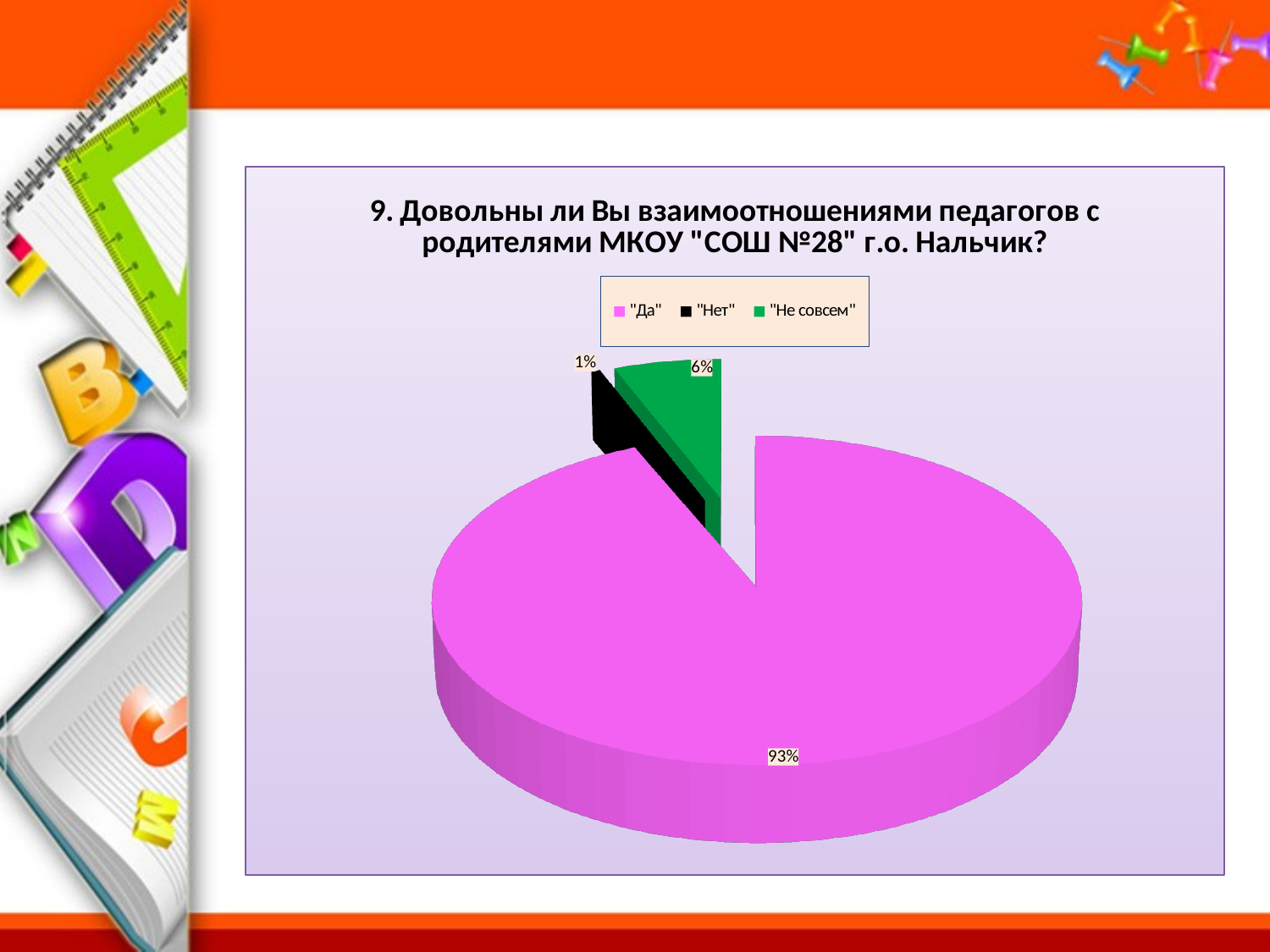
Which answer has the smallest share of the pie? "Нет" What colour is the slice for "Не совсем"? Green What is the difference in percentage points between "Не совсем" and "Нет"? 5 What is the difference in percentage points between "Да" and "Не совсем"? 87 Which is larger, the share for "Не совсем" or the share for "Нет"? "Не совсем" What percentage of respondents answered "Нет"? 1% What percentage of respondents answered "Не совсем"? 6% How many entries does the legend list? 3 Which answer has the largest share of the pie? "Да" How many slices does the pie chart have? 3 What kind of chart is shown on the slide? Pie chart What percentage of respondents answered "Да"? 93%